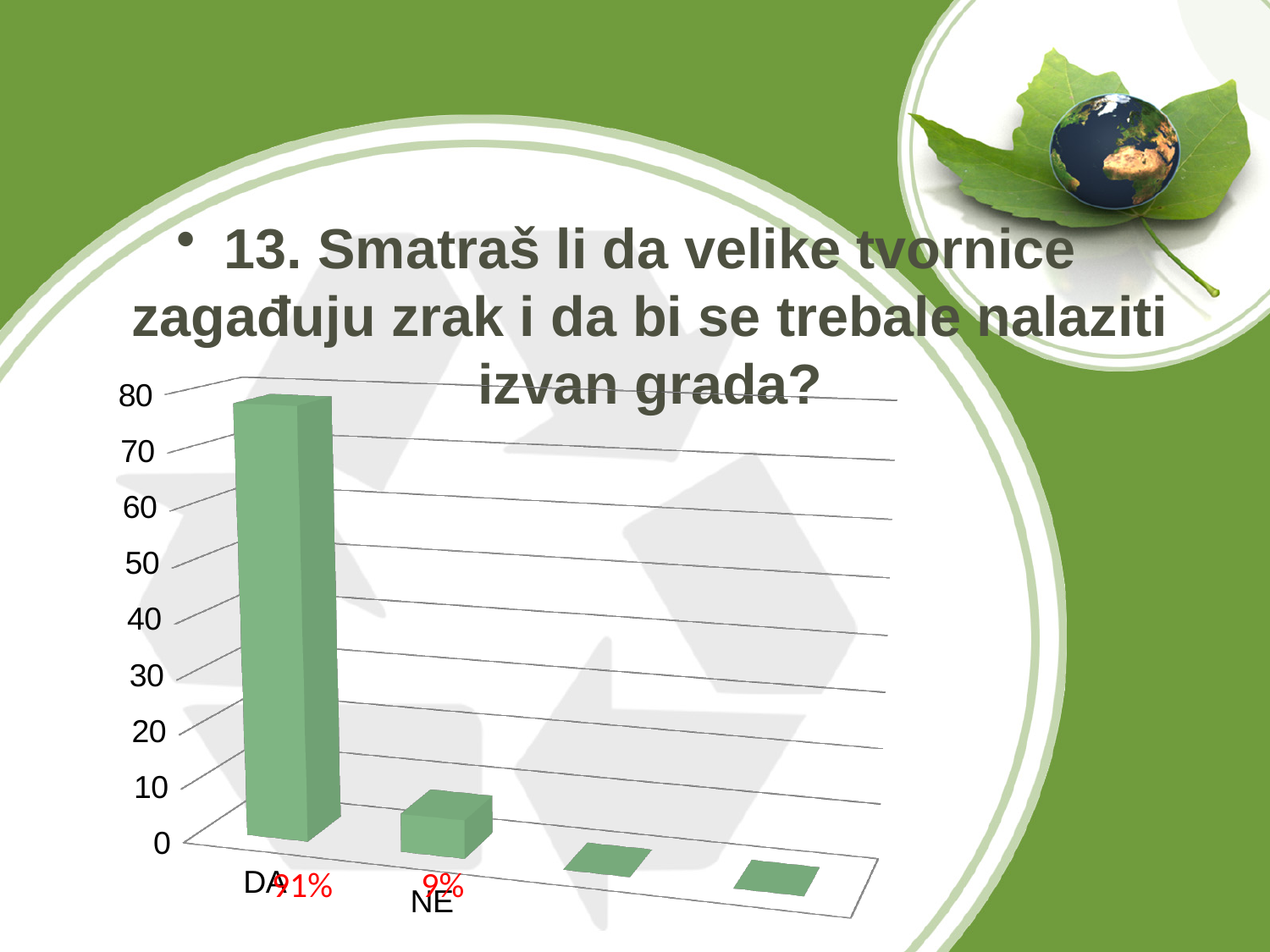
Is the value for DA greater or less than 70? greater What is the difference in percentage points between the DA and NE labels? 82 Is the value for NE greater or less than 20? less What colour are the bars in the chart? green Is the bar for DA taller than the bar for NE? Yes What is the highest value shown on the vertical axis? 80 Is the value for DA greater or less than 40? greater What kind of chart is shown on the slide? bar chart What percentage is shown for the DA category? 91% What percentage is shown for the NE category? 9% Which of the two labelled categories has the lowest bar? NE Which category has the highest bar, DA or NE? DA